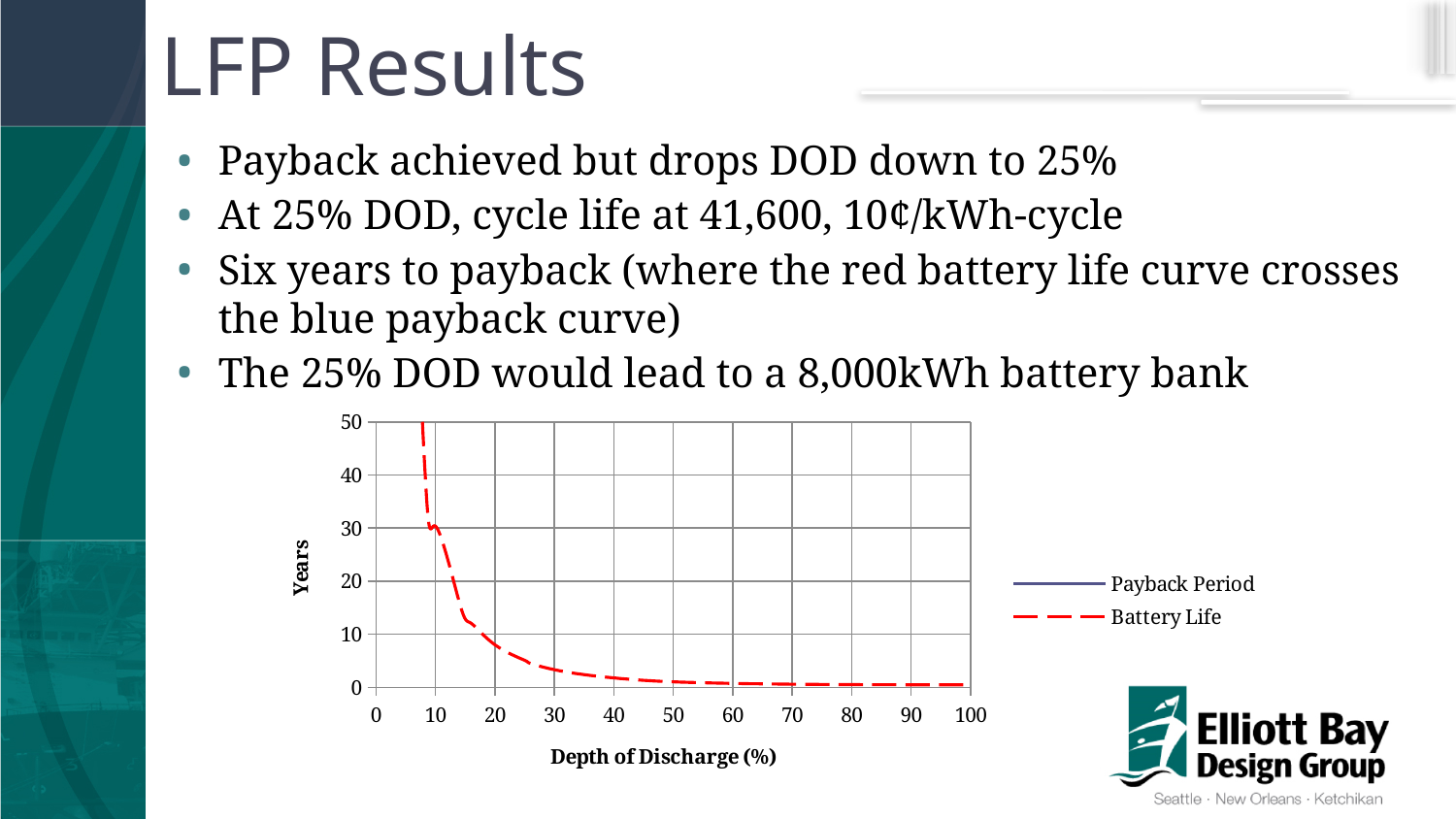
What kind of chart is shown on the slide? line chart Is the Battery Life value at 90% Depth of Discharge greater or less than 10 years? less Is the Battery Life value at 30% Depth of Discharge greater or less than 10 years? less Which is larger, the Battery Life value at 10% Depth of Discharge or at 40% Depth of Discharge? 10% Depth of Discharge Is the Battery Life value at 10% Depth of Discharge greater or less than 20 years? greater Does the Battery Life curve rise or fall as Depth of Discharge increases? fall What is the maximum value shown on the y axis of the chart? 50 What is the title of the y axis of the chart? Years How many series does the chart legend list? 2 What is the title of the x axis of the chart? Depth of Discharge (%)